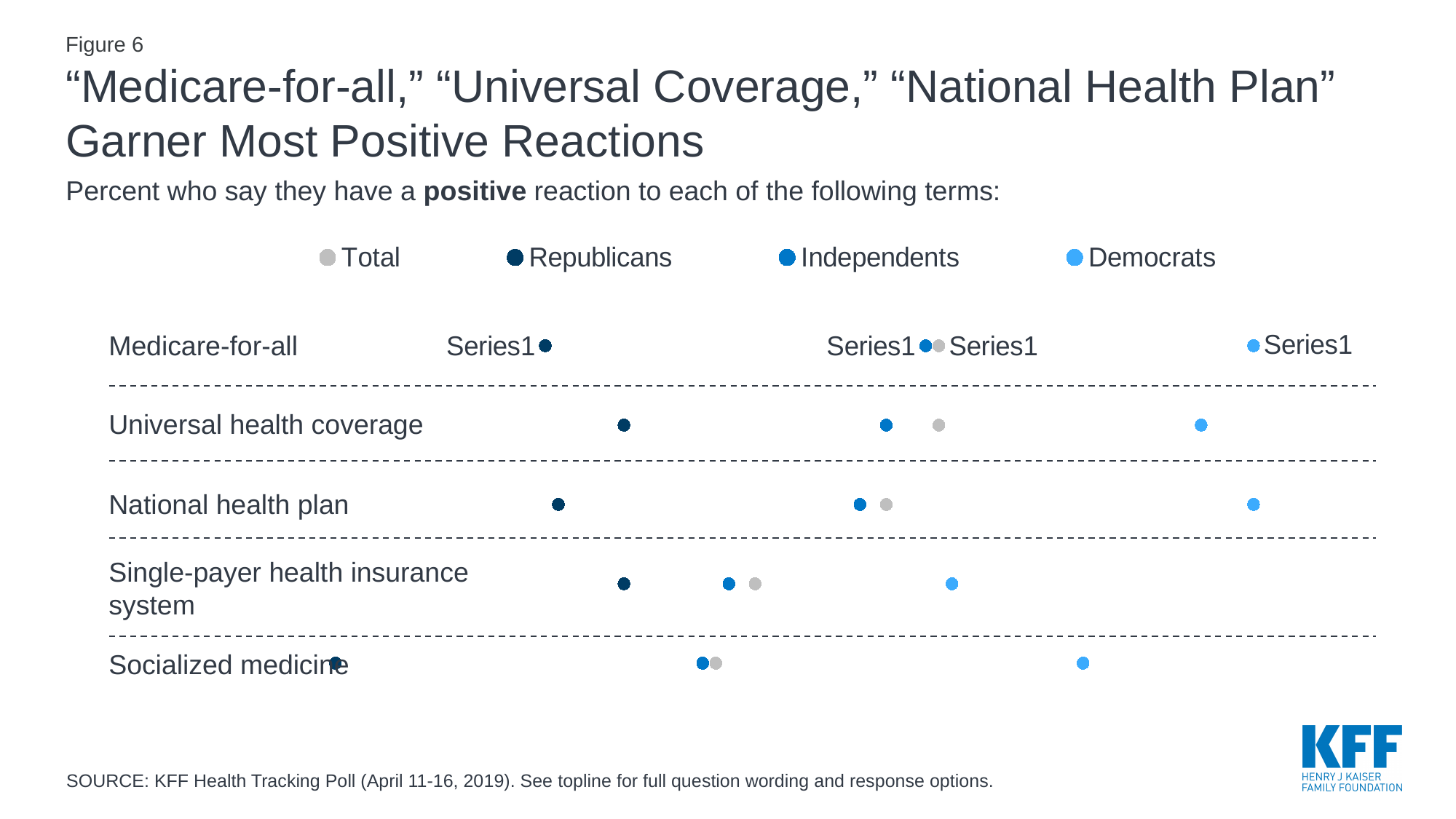
For "Universal health coverage", which is larger, the Total value or the Independents value? Total Among the terms, which has the lowest Democrats value? Single-payer health insurance system Among the terms, which has the lowest Republicans value? Socialized medicine Among the terms, which has the lowest Total value? Socialized medicine For "Socialized medicine", which group has the larger share with a positive reaction, Republicans or Democrats? Democrats How many series does the chart legend list? 4 For "Single-payer health insurance system", which is larger, the Democrats value or the Independents value? Democrats Which series are listed in the chart legend? Total, Republicans, Independents, Democrats What figure number is given for this chart? Figure 6 What kind of chart is shown on the slide? Dot plot For "National health plan", which group has the highest share with a positive reaction? Democrats How many terms (categories) are plotted in the chart? 5